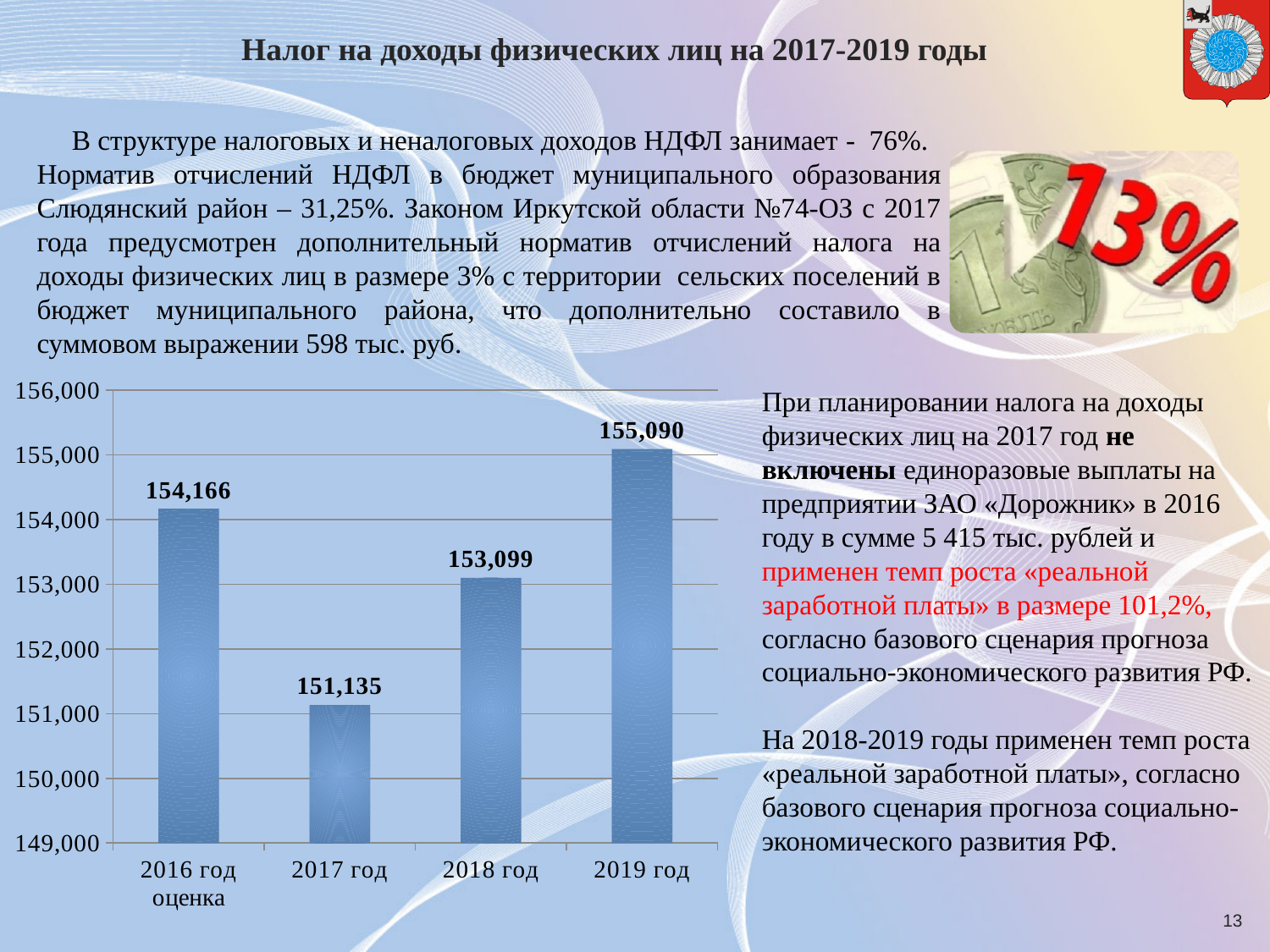
Which is larger, the value for 2016 год оценка or the value for 2018 год? 2016 год оценка What is the value for 2016 год оценка? 154,166 How many years are shown on the chart? 4 What is the difference between the values for 2016 год оценка and 2017 год? 3,031 What is the difference between the values for 2019 год and 2018 год? 1,991 What is the value for 2017 год? 151,135 Is the value for 2018 год greater or less than 153,000? greater What is the value for 2019 год? 155,090 Do the values rise or fall from 2017 год to 2019 год? rise What kind of chart is shown on the slide? bar chart Which year has the highest value? 2019 год Which year has the lowest value? 2017 год